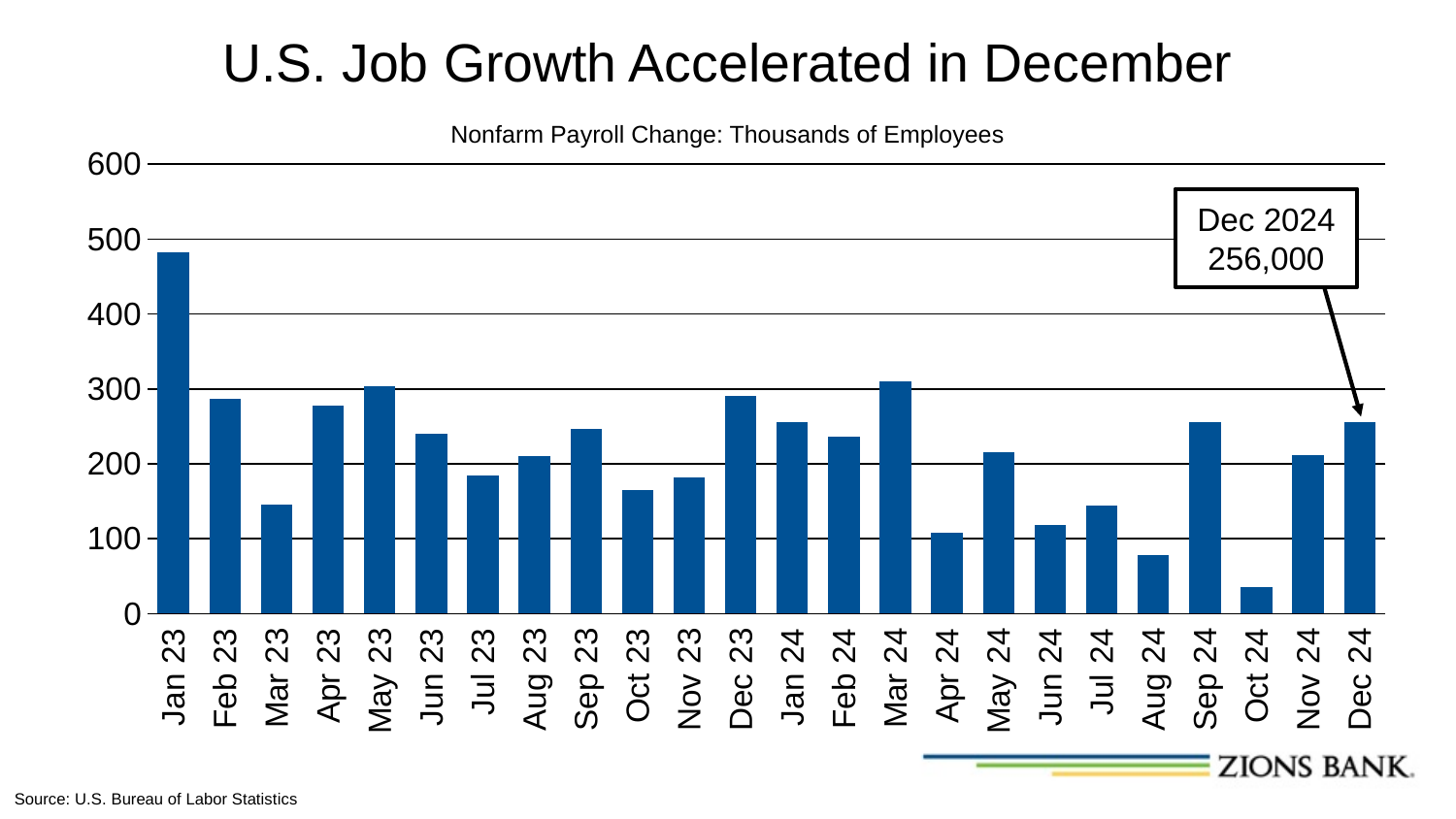
How many months (bars) are plotted in the chart? 24 Is the value for Oct 24 greater or less than 100? less Which month has the highest bar in the chart? Jan 23 Which month has the lowest bar in the chart? Oct 24 Is the value for Jan 23 greater or less than 400? greater What is the subtitle of the chart describing the units plotted? Nonfarm Payroll Change: Thousands of Employees What kind of chart is shown on the slide? bar chart Do the values rise or fall from Oct 24 to Dec 24? rise Which is larger, the value for Oct 24 or the value for Nov 24? Nov 24 Which is larger, the value for Apr 24 or the value for May 24? May 24 What is the nonfarm payroll change value shown for Dec 2024? 256,000 Is the value for Aug 24 greater or less than 100? less